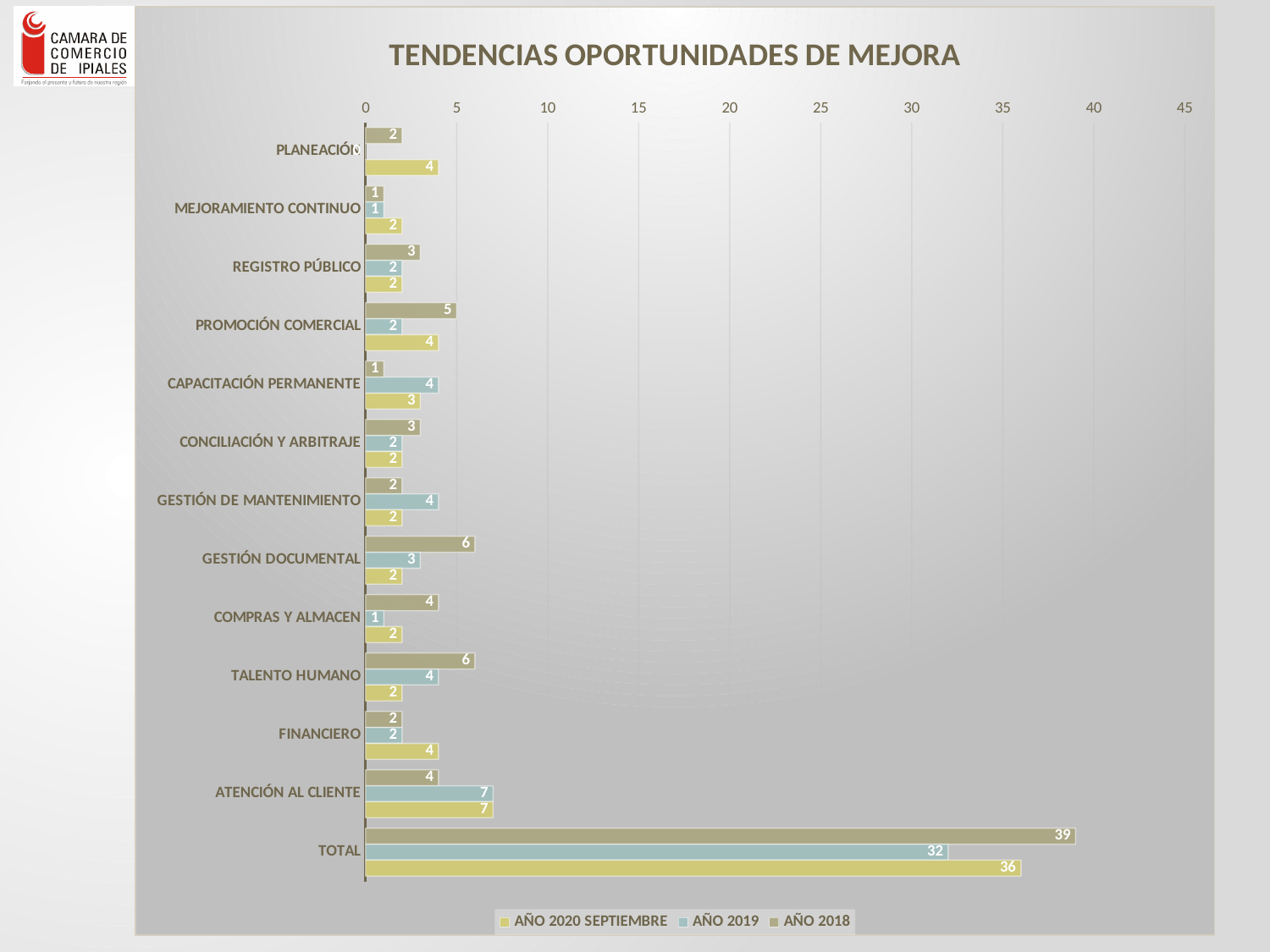
How many series does the legend list? 3 What is the title of the chart? TENDENCIAS OPORTUNIDADES DE MEJORA Which year has the highest TOTAL value? AÑO 2018 What is the difference between the TOTAL for AÑO 2018 and the TOTAL for AÑO 2019? 7 What is the value for ATENCIÓN AL CLIENTE in AÑO 2020 SEPTIEMBRE? 7 Is the TOTAL value for AÑO 2020 SEPTIEMBRE greater or less than 35? greater What is the value for GESTIÓN DOCUMENTAL in AÑO 2018? 6 Excluding TOTAL, which category has the highest value for AÑO 2019? ATENCIÓN AL CLIENTE What is the TOTAL value for AÑO 2018? 39 Which is larger for PROMOCIÓN COMERCIAL: the AÑO 2018 value or the AÑO 2019 value? AÑO 2018 What kind of chart is shown on the slide? bar chart What is the TOTAL value for AÑO 2019? 32